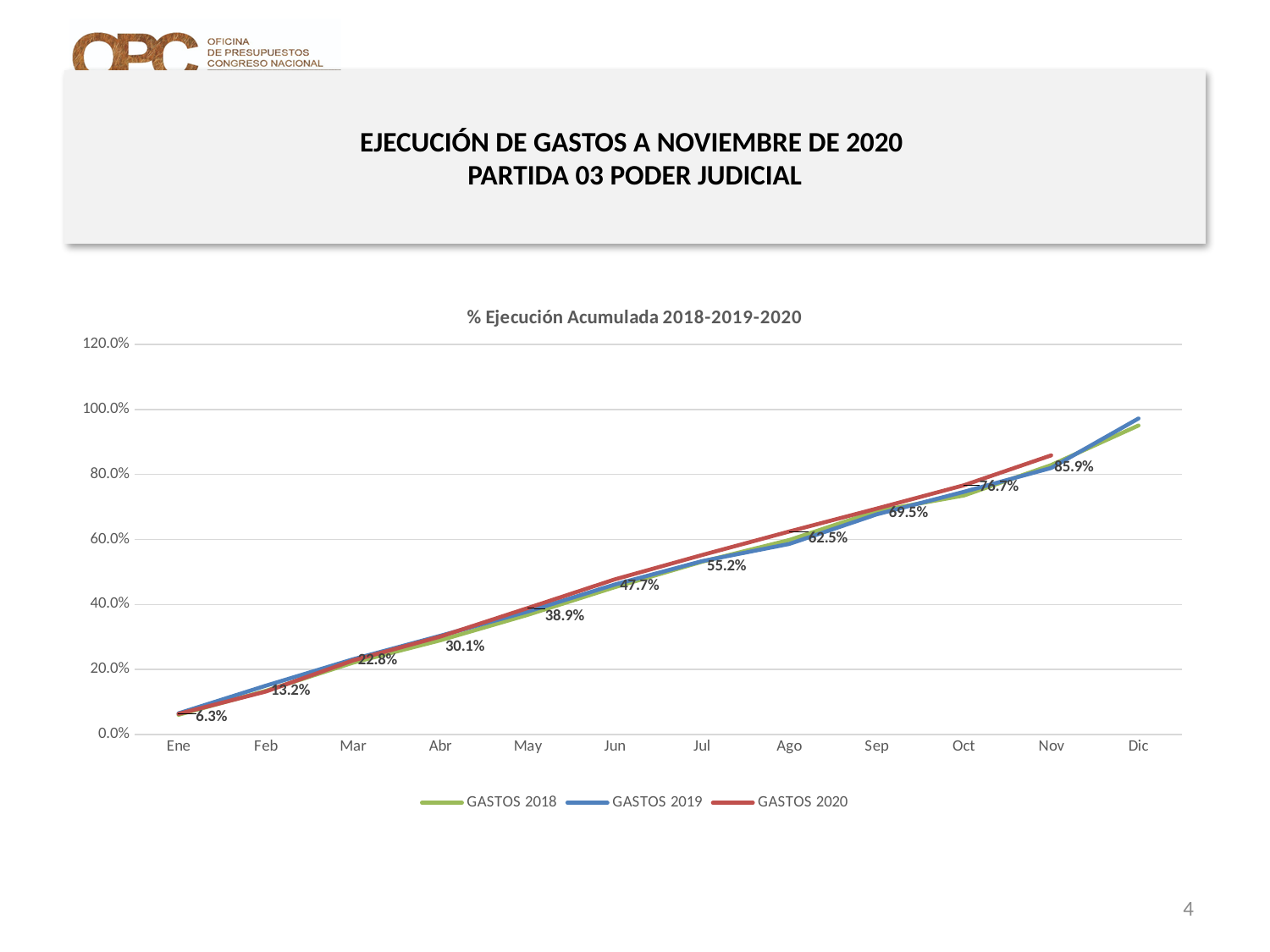
How many months are shown on the x axis? 12 Do the GASTOS 2020 values rise or fall from Ene to Nov? rise What kind of chart is shown on the slide? line chart What is the labelled value for GASTOS 2020 in Ago? 62.5% What is the labelled value for GASTOS 2020 in Ene? 6.3% Is the value for GASTOS 2018 in Mar greater or less than 40.0%? less What is the title of the chart? % Ejecución Acumulada 2018-2019-2020 What is the difference between the GASTOS 2020 values for Nov (85.9%) and Oct (76.7%)? 9.2% How many series does the legend list? 3 What is the labelled value for GASTOS 2020 in May? 38.9% Is the value for GASTOS 2019 in Dic greater or less than 80.0%? greater What is the labelled value for GASTOS 2020 in Nov? 85.9%